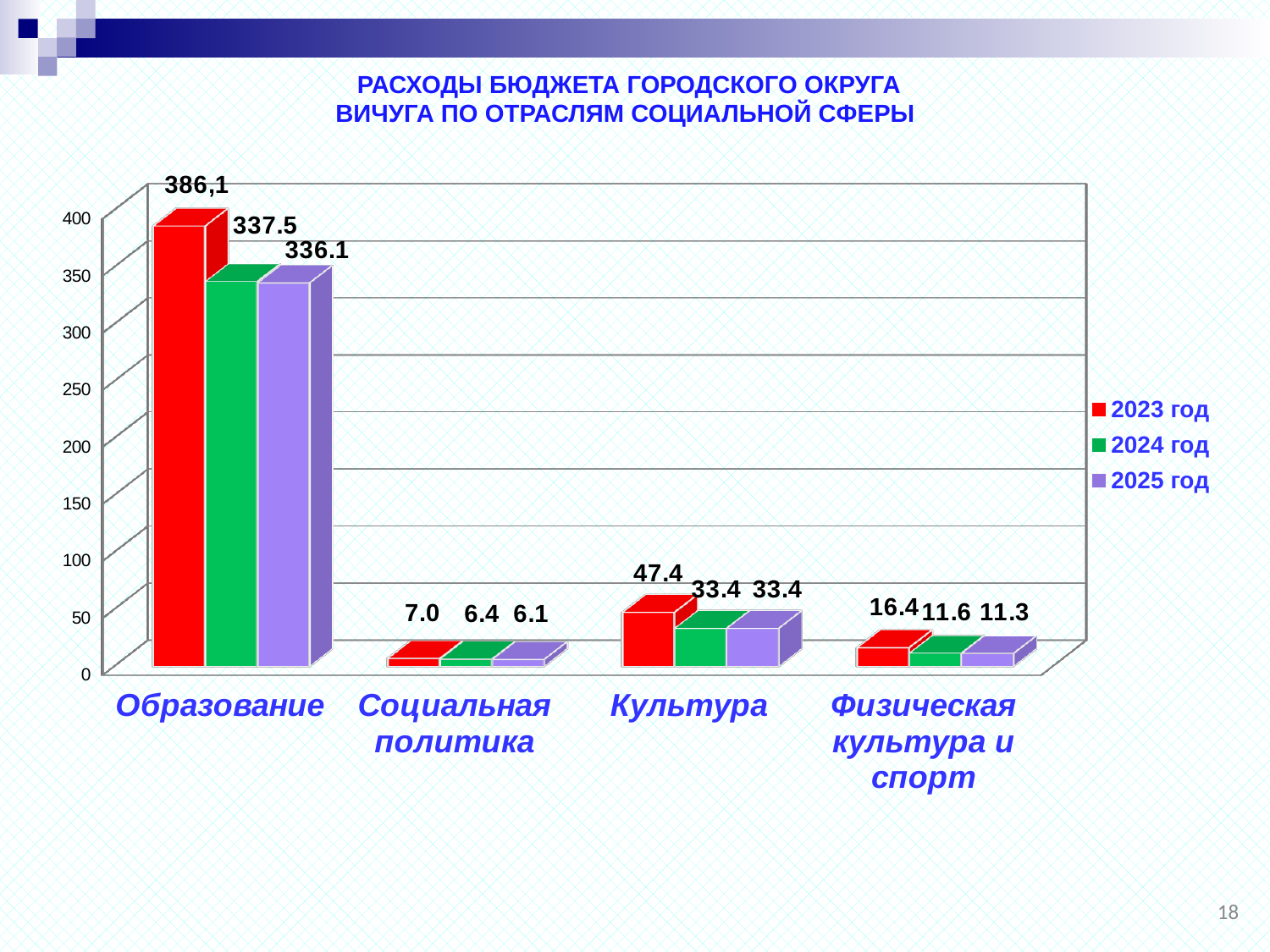
What is the value for Социальная политика in the 2025 год series? 6.1 What is the value for Физическая культура и спорт in the 2024 год series? 11.6 Which category has the lowest value in the 2024 год series? Социальная политика Which category has the highest value in the 2023 год series? Образование What is the difference between the 2023 год and 2024 год values for Культура? 14.0 How many series does the legend list? 3 What kind of chart is shown on the slide? Bar chart Is the 2024 год value for Образование greater or less than 300? greater What is the value for Культура in the 2025 год series? 33.4 Which is larger for Физическая культура и спорт: the 2023 год value or the 2025 год value? 2023 год What is the value for Образование in the 2023 год series? 386,1 How many categories are shown on the x axis? 4